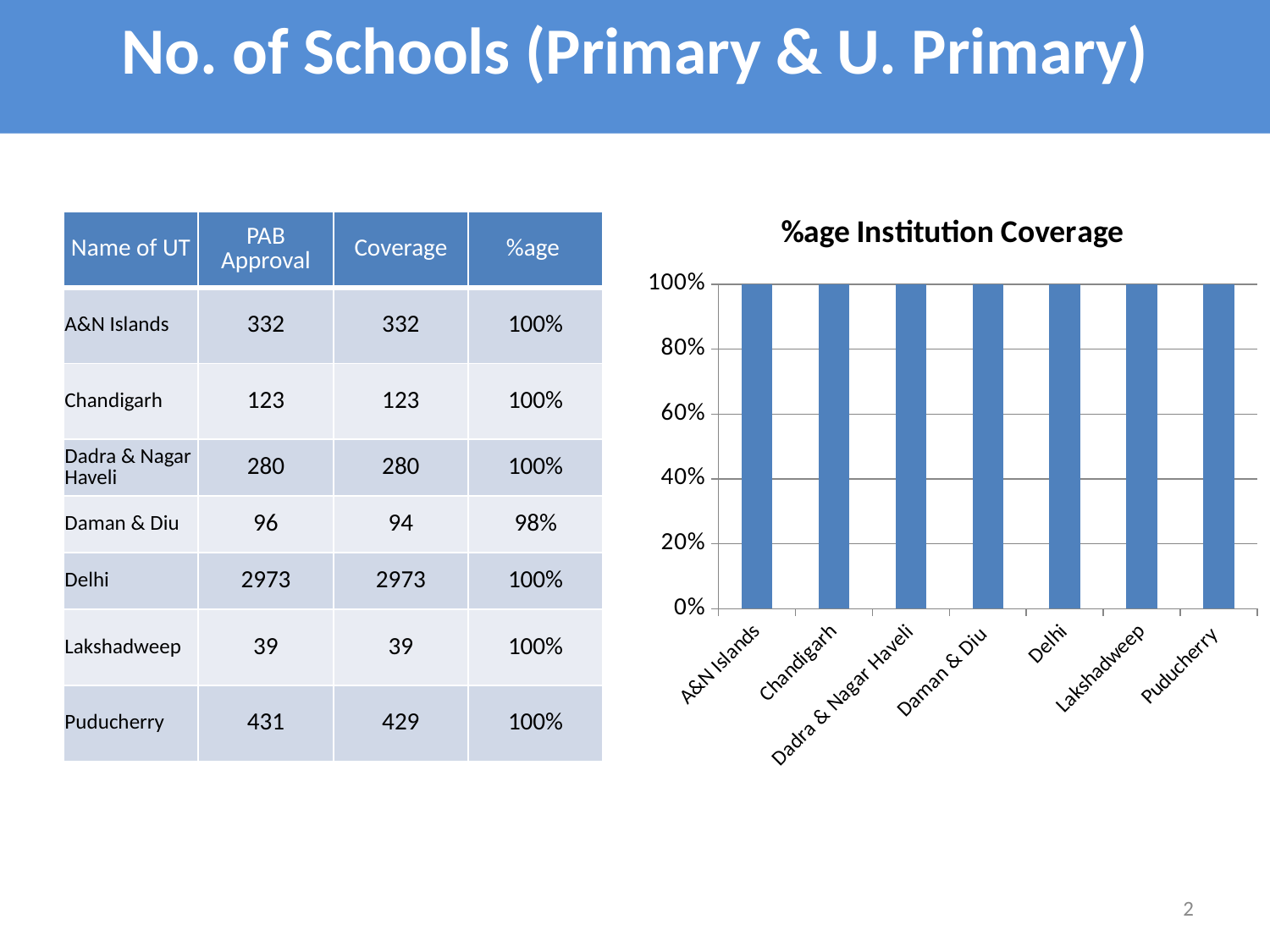
What is the value for Delhi in the chart? 100% Is the value for Daman & Diu greater or less than 80%? greater What is the value for A&N Islands in the chart? 100% What is the title of the chart? %age Institution Coverage Is the value for Puducherry greater or less than 60%? greater Which category is plotted first on the x axis of the chart? A&N Islands What is the value for Lakshadweep in the chart? 100% How many categories (UTs) are plotted in the chart? 7 What is the highest tick value shown on the y axis of the chart? 100% What is the value for Chandigarh in the chart? 100% What kind of chart is shown on the slide? bar chart Do the values in the chart rise, fall, or stay roughly flat across the x axis? stay roughly flat